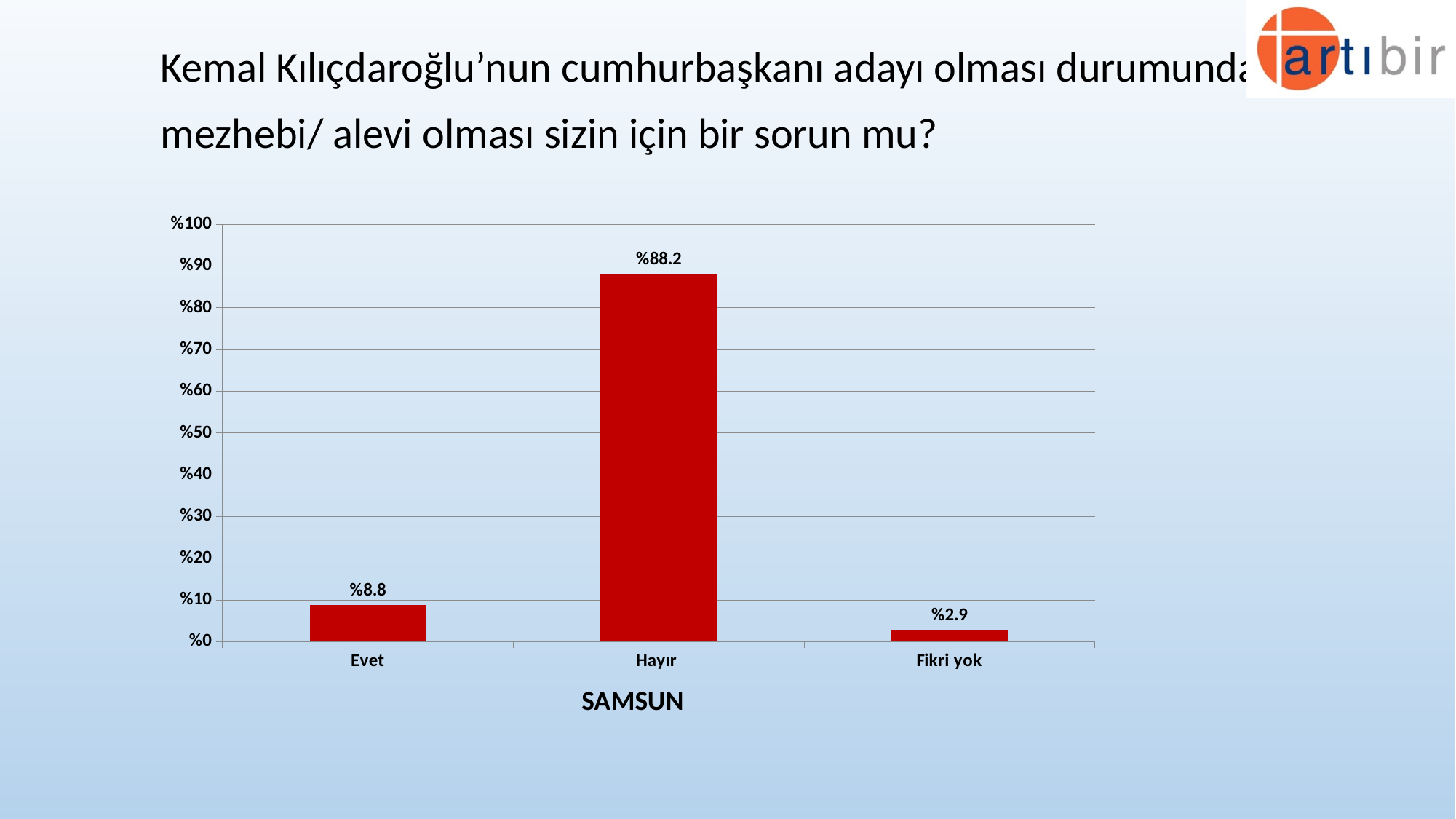
What is the value for Fikri yok? %2.9 What is the value for Evet? %8.8 How many categories are shown on the x axis? 3 What label appears below the x axis of the chart? SAMSUN What is the difference between the values for Hayır and Evet? %79.4 What kind of chart is shown on the slide? bar chart Which is larger, the value for Evet or the value for Fikri yok? Evet Which category has the highest value? Hayır What is the value for Hayır? %88.2 Is the value for Hayır greater or less than %80? greater What is the difference between the values for Evet and Fikri yok? %5.9 Which category has the lowest value? Fikri yok